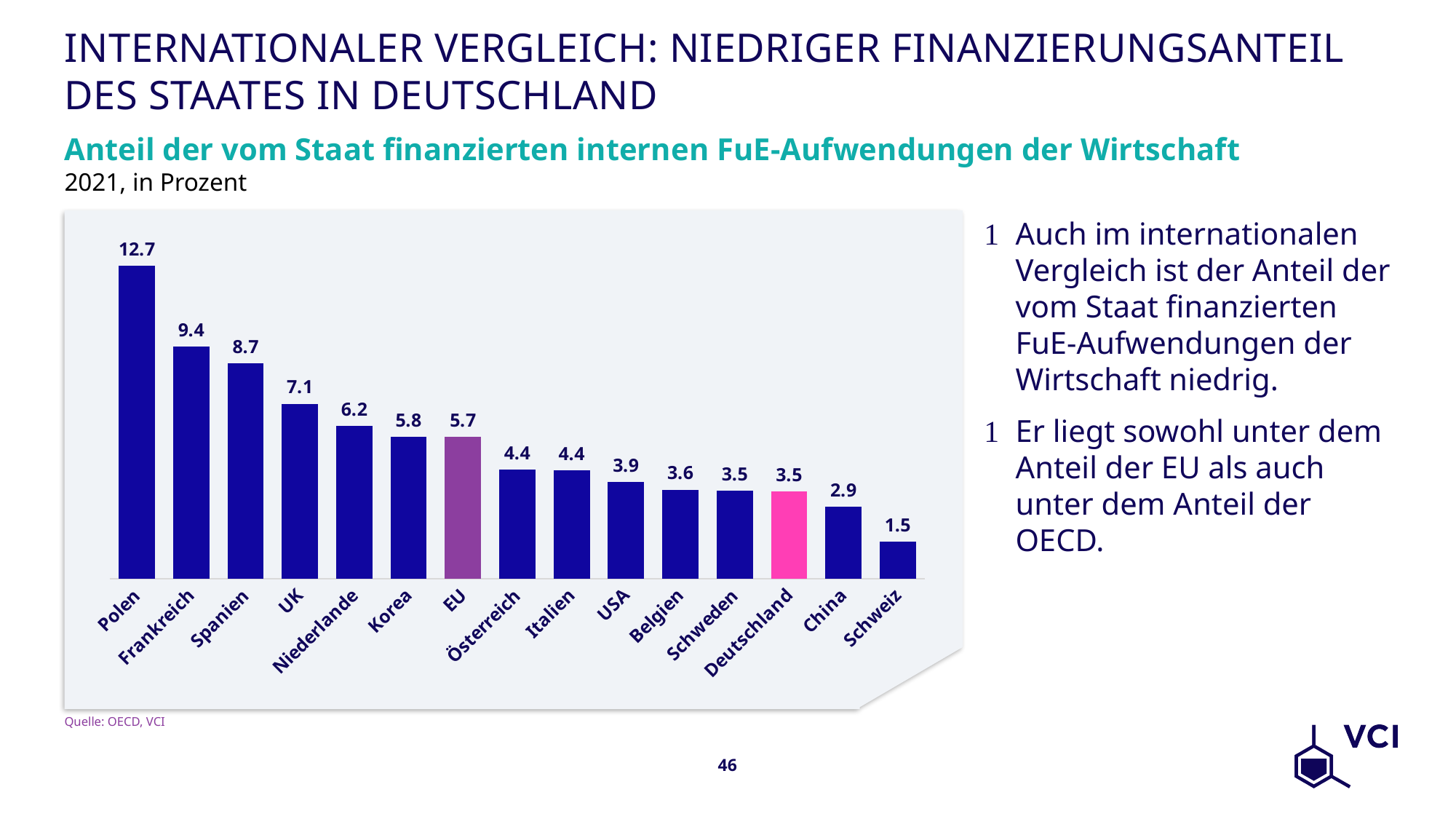
What is the value for EU? 5.7 What is the difference between the values for EU and Deutschland? 2.2 What is the difference between the values for Polen and Schweiz? 11.2 Which is larger, the value for Spanien or the value for UK? Spanien Do the values rise or fall from left to right along the x axis? Fall What kind of chart is shown on the slide? Bar chart Which country has the highest value? Polen What is the value for Frankreich? 9.4 Which country has the lowest value? Schweiz How many categories are shown in the chart? 15 Which bar is highlighted in pink? Deutschland What is the value for Deutschland? 3.5